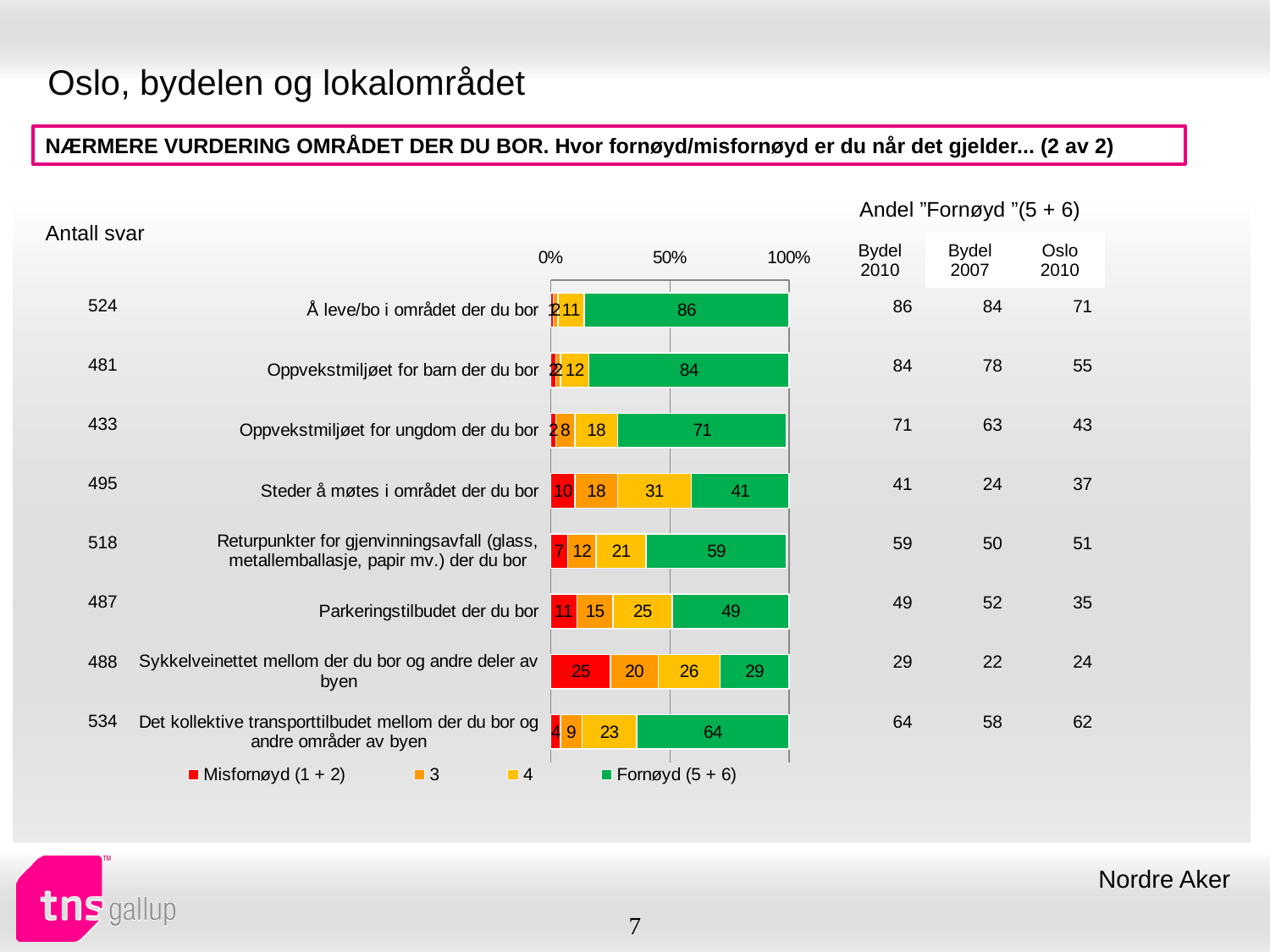
What is the first entry in the chart legend? Misfornøyd (1 + 2) What kind of chart is shown on the slide? bar chart What is the Fornøyd (5 + 6) value for 'Sykkelveinettet mellom der du bor og andre deler av byen'? 29 What is the difference between the Fornøyd (5 + 6) values for 'Å leve/bo i området der du bor' and 'Oppvekstmiljøet for barn der du bor'? 2 How many categories (statements) are plotted in the chart? 8 What is the Misfornøyd (1 + 2) value for 'Sykkelveinettet mellom der du bor og andre deler av byen'? 25 Which category has the highest Fornøyd (5 + 6) value? Å leve/bo i området der du bor What is the value of the '4' series for 'Parkeringstilbudet der du bor'? 25 What is the Fornøyd (5 + 6) value for 'Steder å møtes i området der du bor'? 41 How many series does the chart legend list? 4 Which has a larger Fornøyd (5 + 6) value: 'Parkeringstilbudet der du bor' or 'Returpunkter for gjenvinningsavfall (glass, metallemballasje, papir mv.) der du bor'? Returpunkter for gjenvinningsavfall (glass, metallemballasje, papir mv.) der du bor Which category has the lowest Fornøyd (5 + 6) value? Sykkelveinettet mellom der du bor og andre deler av byen